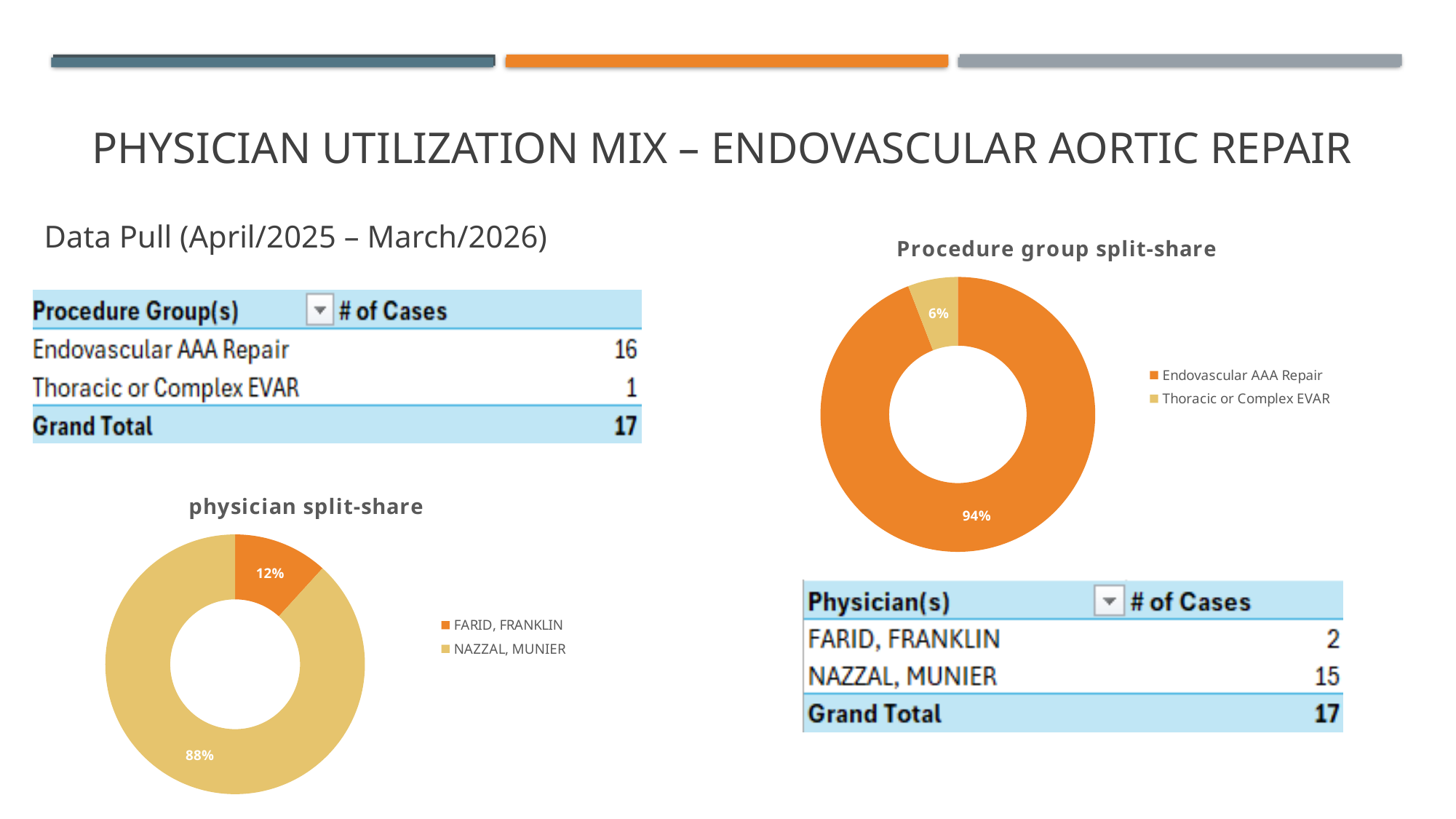
In the 'physician split-share' chart, what share does NAZZAL, MUNIER have? 88% How many entries does the legend of the 'physician split-share' chart list? 2 In the 'physician split-share' chart, what share does FARID, FRANKLIN have? 12% In the 'Procedure group split-share' chart, what share does Thoracic or Complex EVAR have? 6% What colour is the FARID, FRANKLIN slice in the 'physician split-share' chart? Orange In the 'physician split-share' chart, which physician has the largest share? NAZZAL, MUNIER In the 'Procedure group split-share' chart, which procedure group has the smallest share? Thoracic or Complex EVAR How many categories does the 'Procedure group split-share' chart show? 2 In the 'Procedure group split-share' chart, which is larger: the share for Endovascular AAA Repair or for Thoracic or Complex EVAR? Endovascular AAA Repair What kind of chart is the 'physician split-share' chart? Doughnut (pie) chart In the 'physician split-share' chart, what is the difference in percentage points between NAZZAL, MUNIER and FARID, FRANKLIN? 76 percentage points